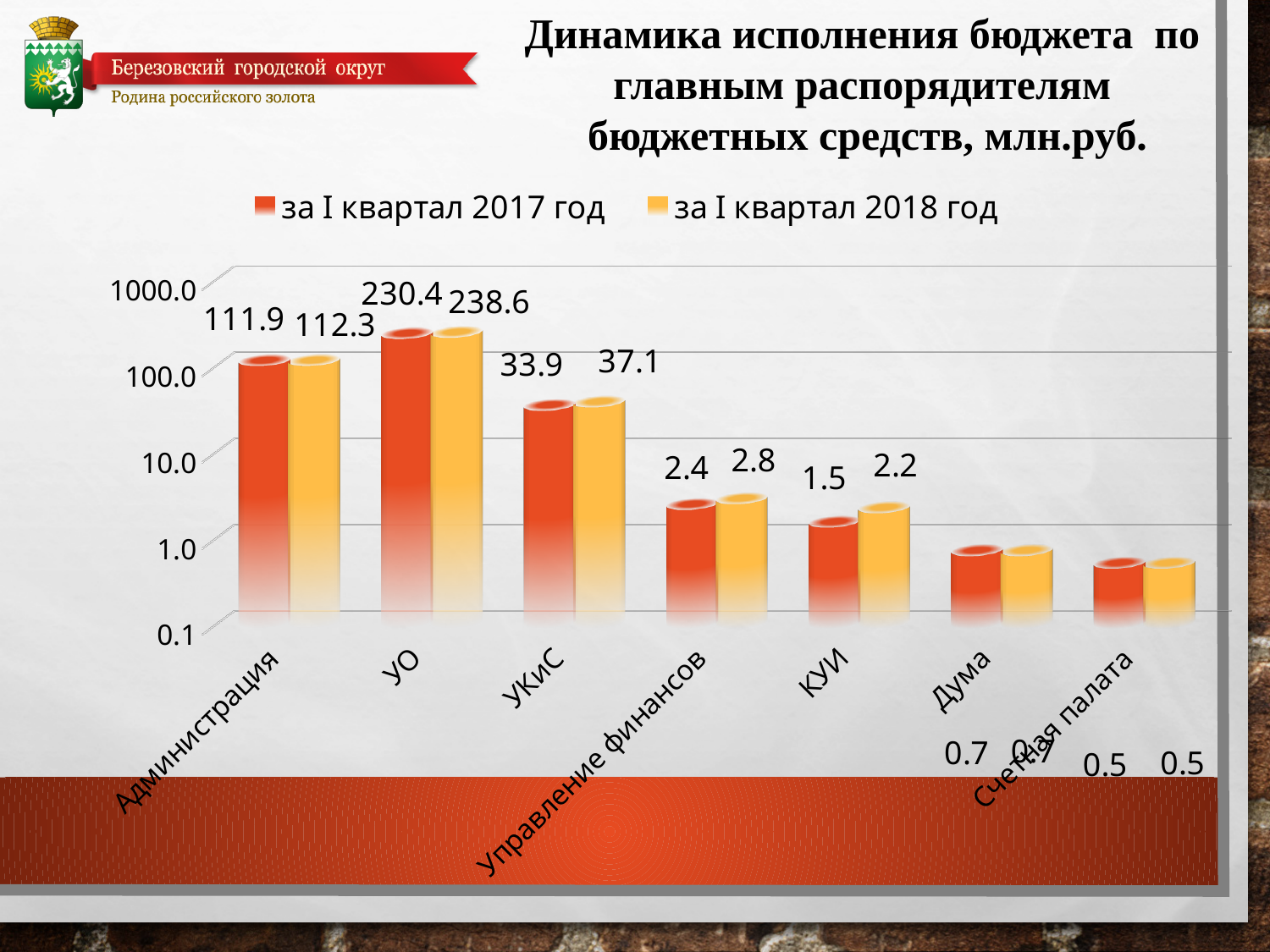
What is the value for УКиС for за I квартал 2017 год? 33.9 What is the value for УО for за I квартал 2018 год? 238.6 How many categories are shown on the x axis? 7 What kind of chart is shown on the slide? bar chart What is the value for КУИ for за I квартал 2018 год? 2.2 How many series does the legend list? 2 Is the value for УКиС for за I квартал 2018 год greater or less than 100.0? less What is the difference between the за I квартал 2018 год and за I квартал 2017 год values for УО? 8.2 What is the value for Администрация for за I квартал 2017 год? 111.9 Which is larger for Управление финансов: the value for за I квартал 2017 год or за I квартал 2018 год? за I квартал 2018 год Which category has the lowest value for за I квартал 2017 год? Счетная палата Which category has the highest value for за I квартал 2018 год? УО